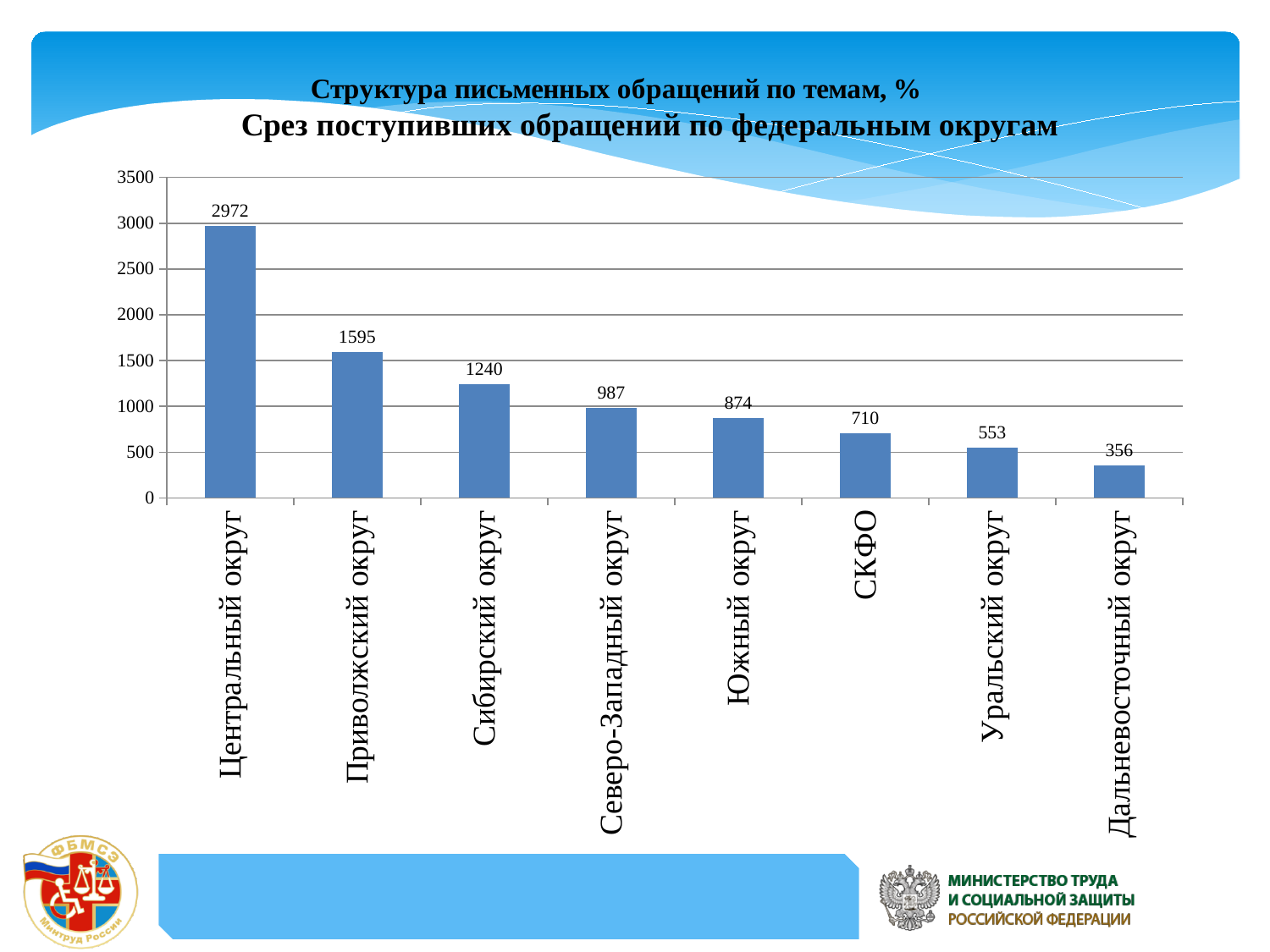
Which federal district has the lowest value? Дальневосточный округ Is the value for Приволжский округ greater or less than 1500? greater Which is larger, the value for Северо-Западный округ or the value for Южный округ? Северо-Западный округ What is the difference between the values for Уральский округ and Дальневосточный округ? 197 How many federal districts are shown on the chart? 8 What is the value for Центральный округ? 2972 What is the difference between the values for Центральный округ and Приволжский округ? 1377 What kind of chart is shown on the slide? bar chart Do the values rise or fall from left to right along the x axis? fall What is the value for СКФО? 710 Which federal district has the highest value? Центральный округ What is the value for Сибирский округ? 1240